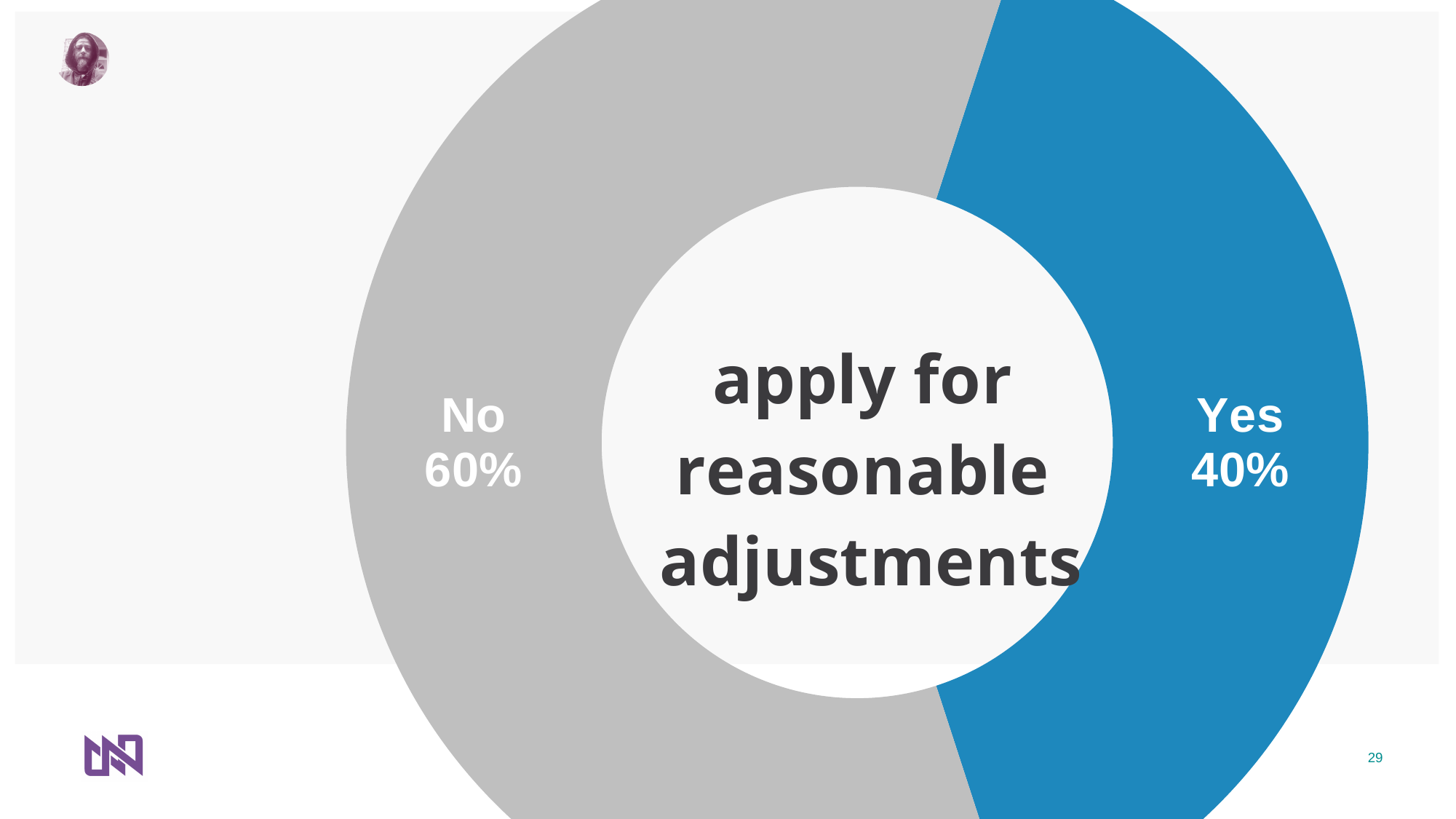
What share of the chart does the No slice represent? 60% What kind of chart is shown on the slide? Doughnut (pie) chart What percentage of respondents answered "Yes" to applying for reasonable adjustments? 40% What is the difference in percentage points between the No and Yes shares? 20 percentage points Which response has the smaller share of the chart? Yes Is the share for Yes larger or smaller than the share for No? smaller What text appears in the centre of the doughnut chart? apply for reasonable adjustments What colour is the Yes segment of the chart? Blue How many categories are shown in the chart? 2 What percentage of respondents answered "No" to applying for reasonable adjustments? 60% Which response has the larger share of the chart, Yes or No? No